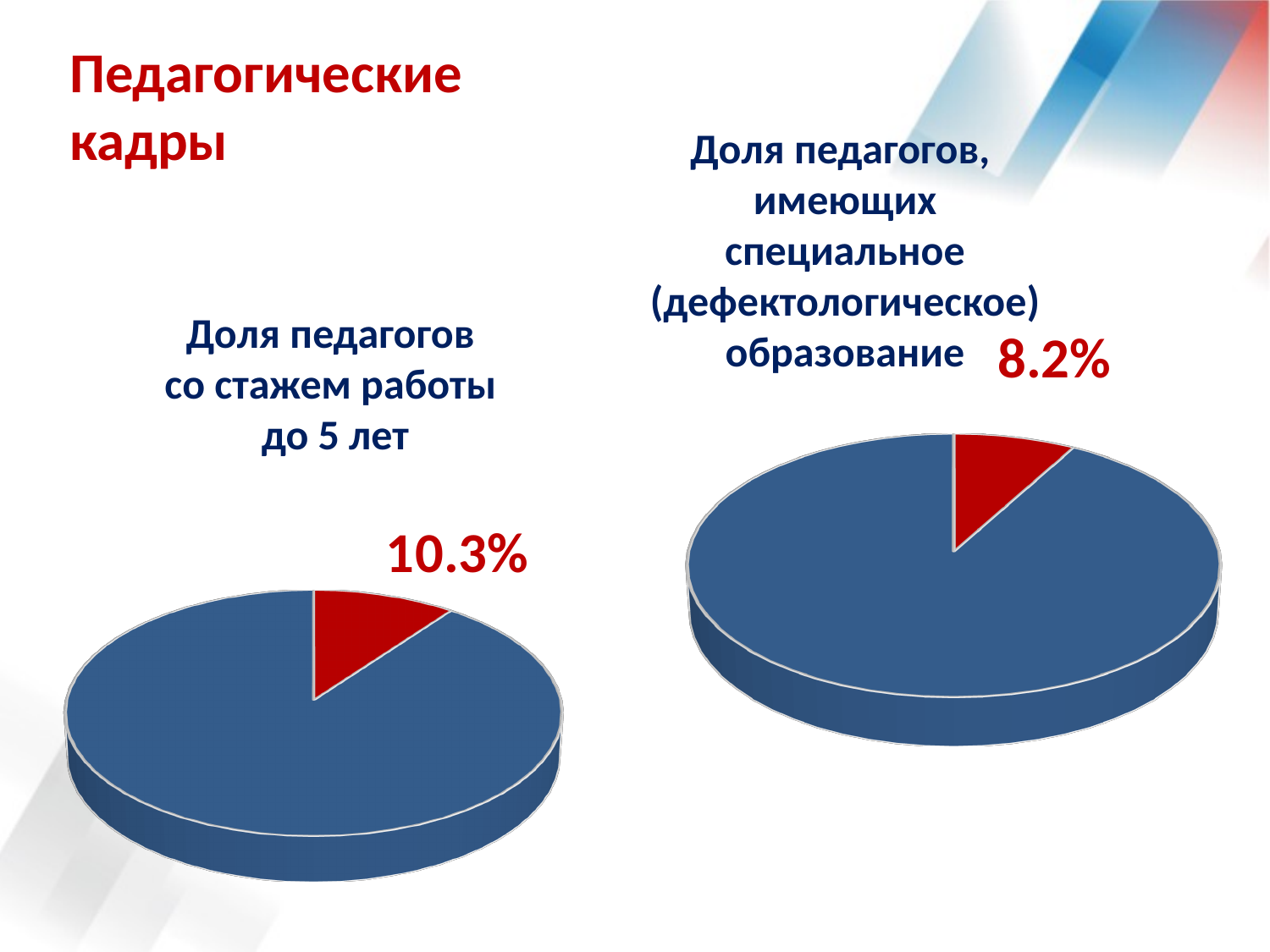
In the left pie chart, is the red slice greater or less than 50% of the pie? less In the right pie chart, is the blue slice greater or less than 50% of the pie? greater How many slices does the right pie chart contain? 2 What is the title of the right pie chart? Доля педагогов, имеющих специальное (дефектологическое) образование What is the difference between the highlighted share in the left chart (10.3%) and the highlighted share in the right chart (8.2%)? 2.1 percentage points What kind of chart is used on the right side of the slide? Pie chart What kind of chart is used on the left side of the slide? Pie chart Which highlighted share is larger: teachers with up to 5 years of experience (left chart) or teachers with special (defectological) education (right chart)? Teachers with up to 5 years of experience (10.3%) In the right pie chart (Доля педагогов, имеющих специальное (дефектологическое) образование), what share is shown by the red slice? 8.2% How many slices does the left pie chart contain? 2 In the left pie chart (Доля педагогов со стажем работы до 5 лет), what share is shown by the red slice? 10.3% What colour is used for the highlighted (labelled) slice in both pie charts? Red